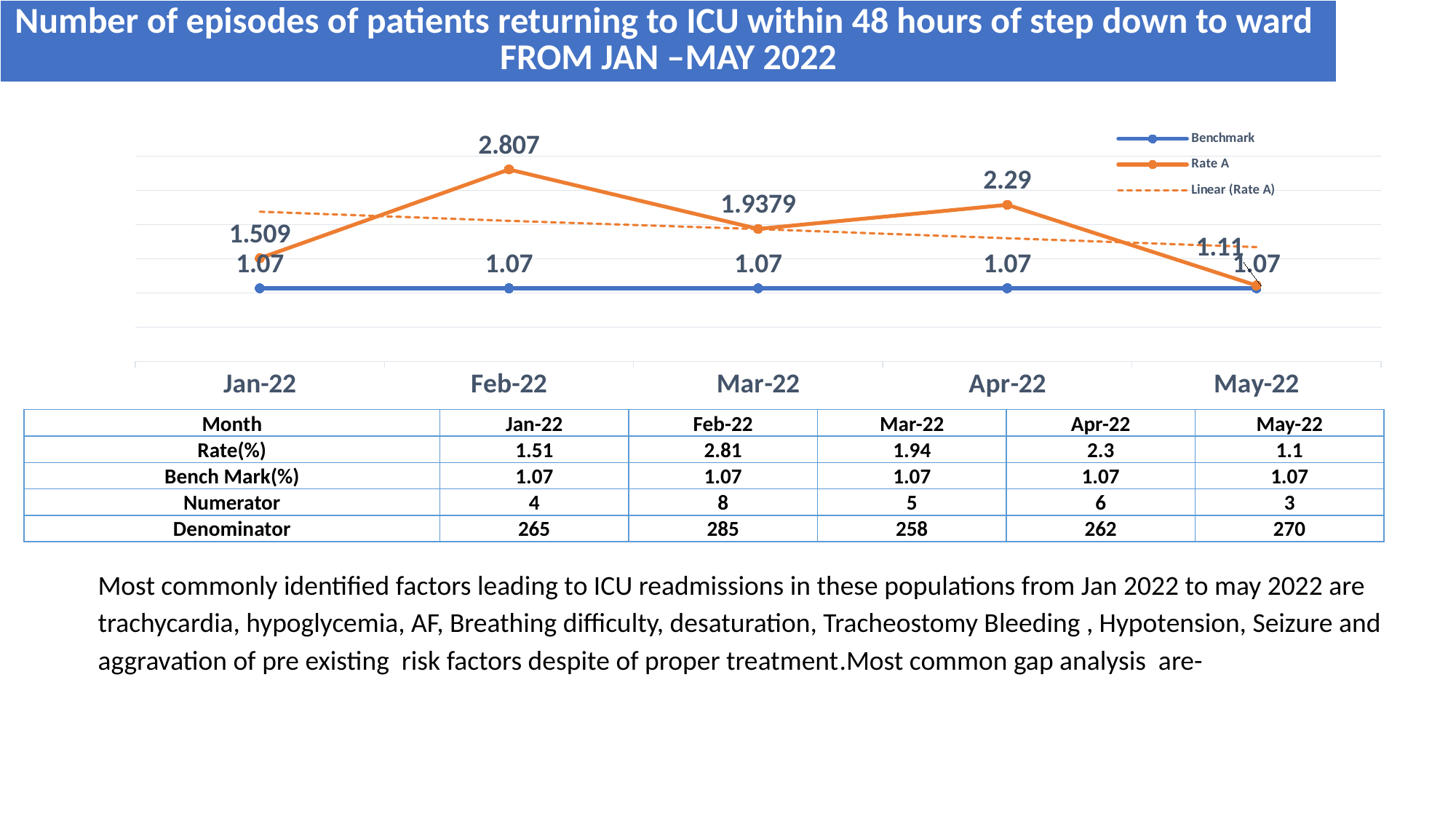
Which is larger, the Rate A value for Apr-22 or the Rate A value for Mar-22? Apr-22 What is the difference between the Rate A value for Apr-22 and the Benchmark value for Apr-22? 1.22 In which month is Rate A lowest? May-22 In which month is Rate A highest? Feb-22 Does the Rate A line rise or fall from Feb-22 to Mar-22? Fall What type of chart is shown on the slide? Line chart What is the Rate A value for Mar-22? 1.9379 What is the Rate A value for Jan-22? 1.509 What is the Rate A value for Feb-22? 2.807 How many months are plotted on the x axis? 5 What is the Benchmark value for Apr-22? 1.07 How many entries does the legend list? 3